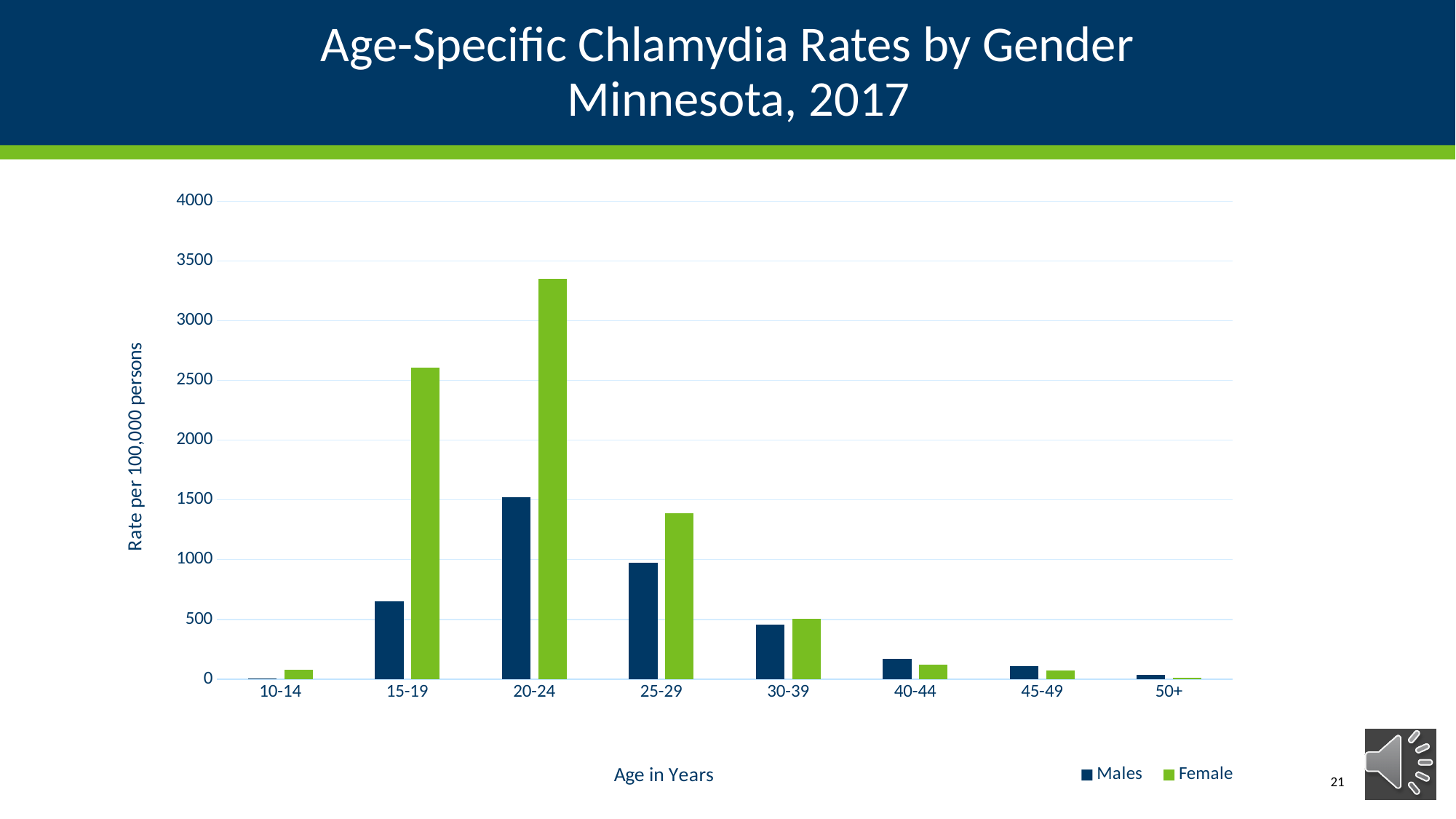
What kind of chart is shown on the slide? bar chart Is the Males value for 15-19 greater or less than 500? greater Is the Males value for 20-24 greater or less than 1000? greater Which age group has the highest Males rate? 20-24 Which age group has the highest Female rate? 20-24 How many series does the legend list? 2 Is the Female value for 15-19 greater or less than 2000? greater For the 15-19 age group, which is larger, the Males rate or the Female rate? Female How many age groups are shown on the x axis? 8 Which age group has the lowest Female rate? 50+ What is the title of the y axis? Rate per 100,000 persons